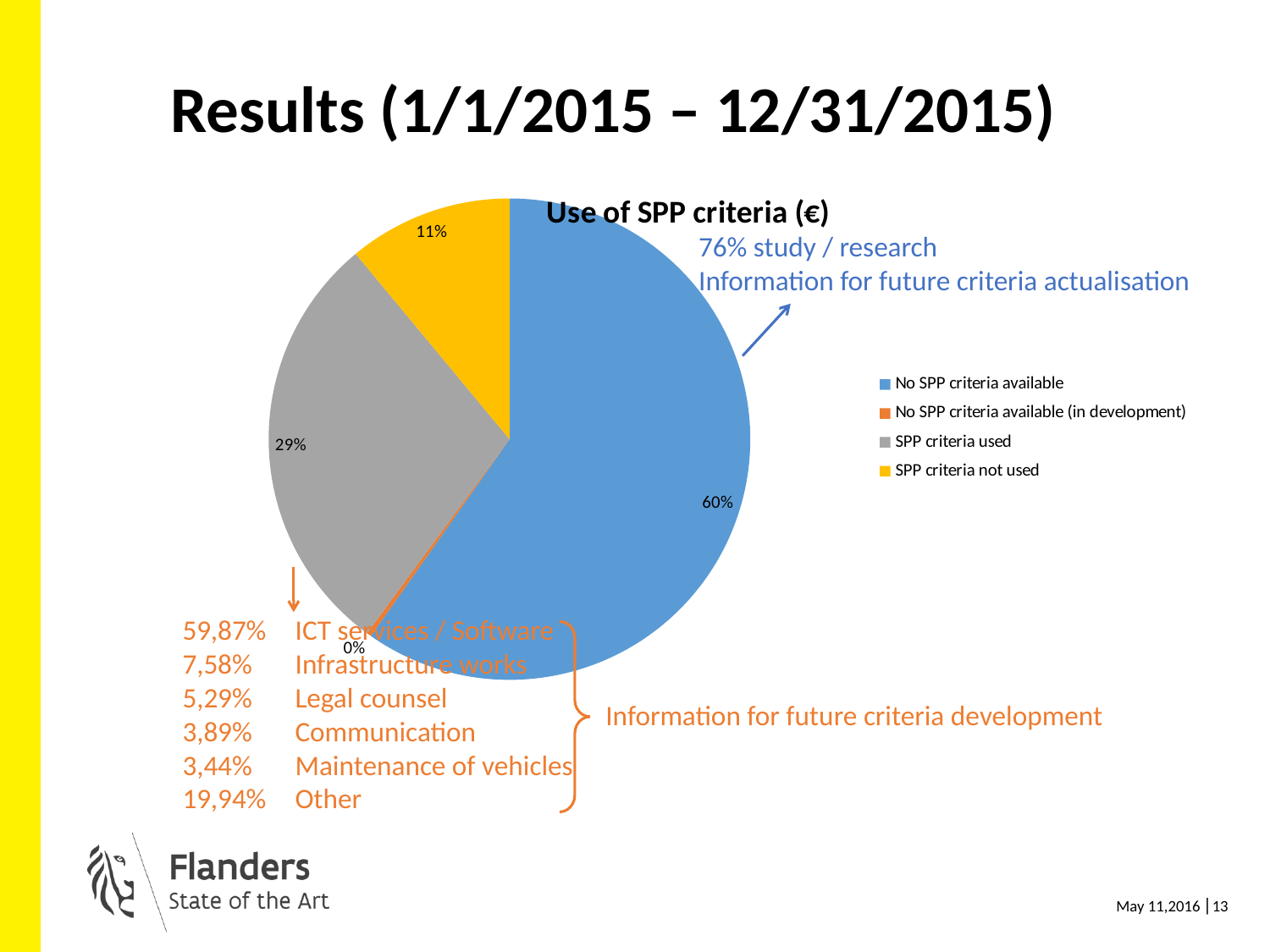
What is the difference in percentage points between 'No SPP criteria available' and 'SPP criteria used'? 31 What share of the pie is labelled for 'SPP criteria not used'? 11% What colour is the slice for 'SPP criteria not used'? yellow What share of the pie is labelled for 'SPP criteria used'? 29% How many entries does the chart legend list? 4 Which is larger: the slice for 'SPP criteria used' or the slice for 'SPP criteria not used'? SPP criteria used What share of the pie is labelled for 'No SPP criteria available (in development)'? 0% What type of chart is shown on the slide? pie chart What is the title of the chart? Use of SPP criteria (€) Which category has the smallest slice of the pie? No SPP criteria available (in development) Which category has the largest slice of the pie? No SPP criteria available